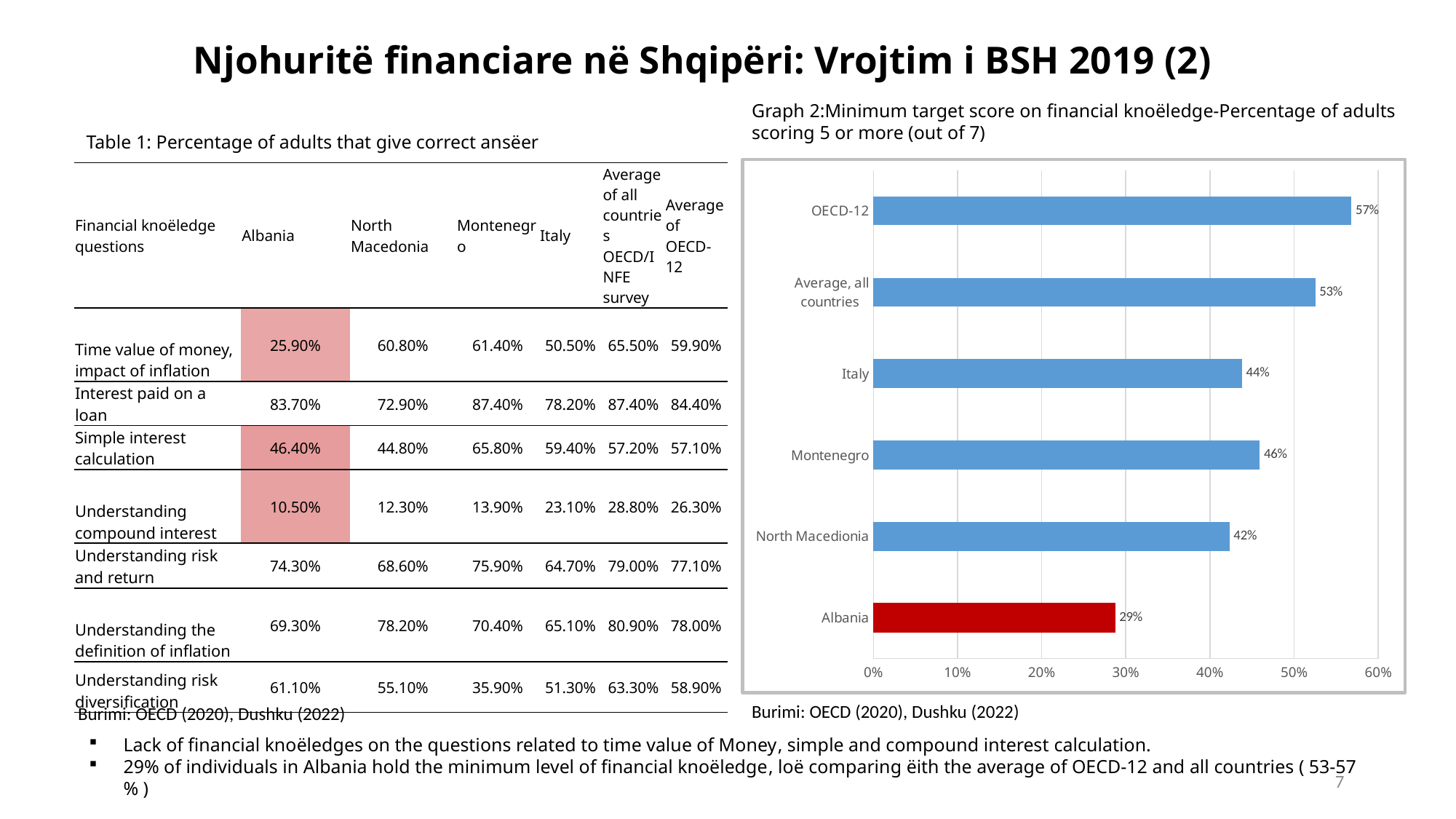
Which category has the lowest value in the bar chart? Albania Which category has the highest value in the bar chart? OECD-12 How many categories are shown in the bar chart? 6 Which bar in the chart is coloured red rather than blue? Albania Which has a larger value in the bar chart, Montenegro or North Macedonia? Montenegro What is the difference between the OECD-12 value and the Albania value in the bar chart? 28% What kind of chart is shown on the right of the slide? Bar chart What is the value for OECD-12 in the bar chart? 57% What is the value for Montenegro in the bar chart? 46% What is the value for Albania in the bar chart? 29% What is the value for Italy in the bar chart? 44% What is the value for 'Average, all countries' in the bar chart? 53%